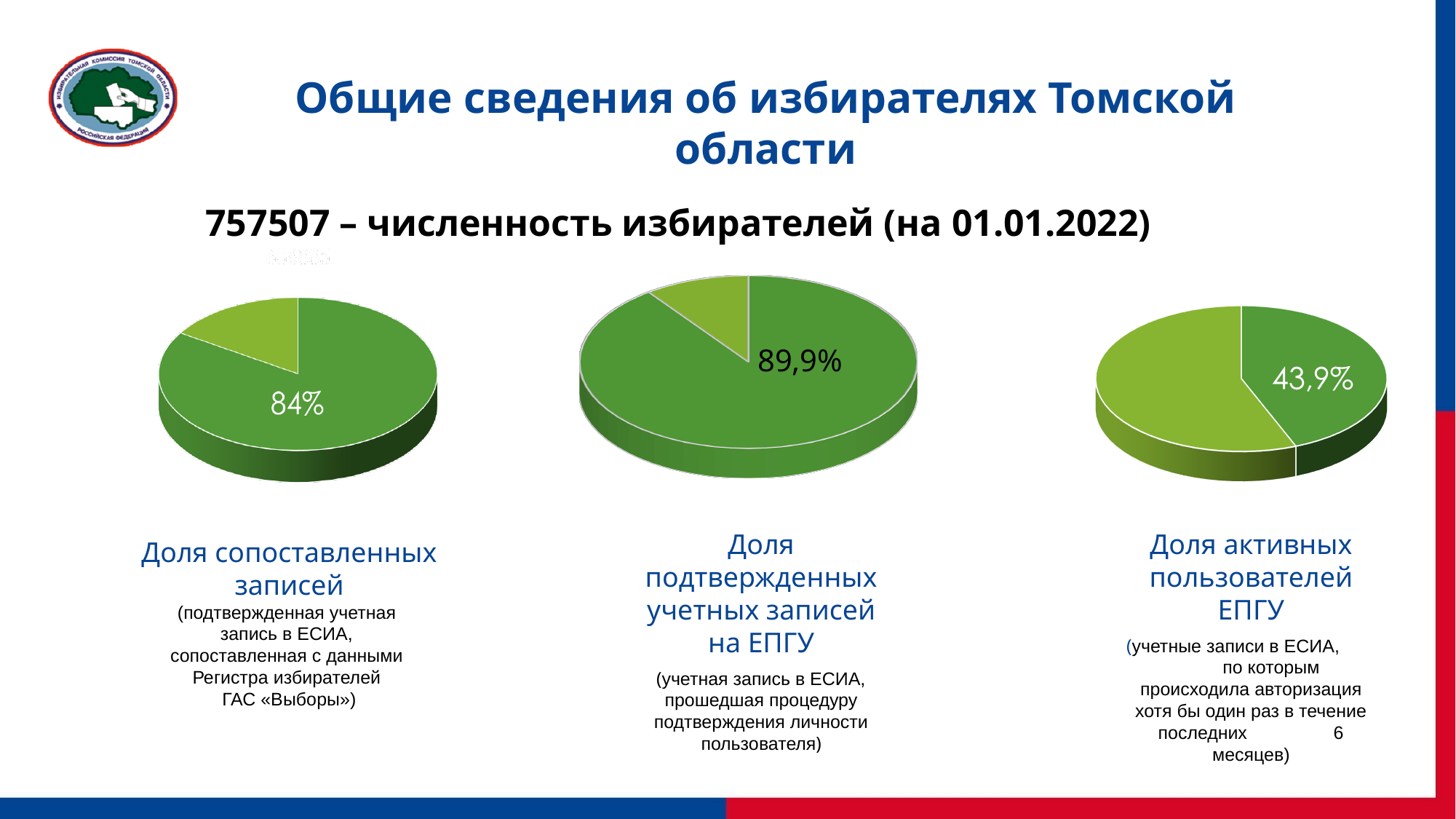
What is the caption under the left pie chart? Доля сопоставленных записей What share is labelled on the left pie chart (Доля сопоставленных записей)? 84% Which of the three pie charts shows the smallest labelled share? The right chart (Доля активных пользователей ЕПГУ) What is the difference between the labelled share on the middle pie chart and the labelled share on the left pie chart? 5,9% Which is larger: the labelled share on the left pie chart or on the middle pie chart? The middle chart (89,9%) What kind of charts are shown on the slide? Pie charts What share is labelled on the right pie chart (Доля активных пользователей ЕПГУ)? 43,9% How many pie charts are on the slide? 3 Is the labelled share on the right pie chart (Доля активных пользователей ЕПГУ) greater or less than 50%? less How many slices does the right pie chart (Доля активных пользователей ЕПГУ) have? 2 Which of the three pie charts shows the largest labelled share? The middle chart (Доля подтвержденных учетных записей на ЕПГУ) What share is labelled on the middle pie chart (Доля подтвержденных учетных записей на ЕПГУ)? 89,9%